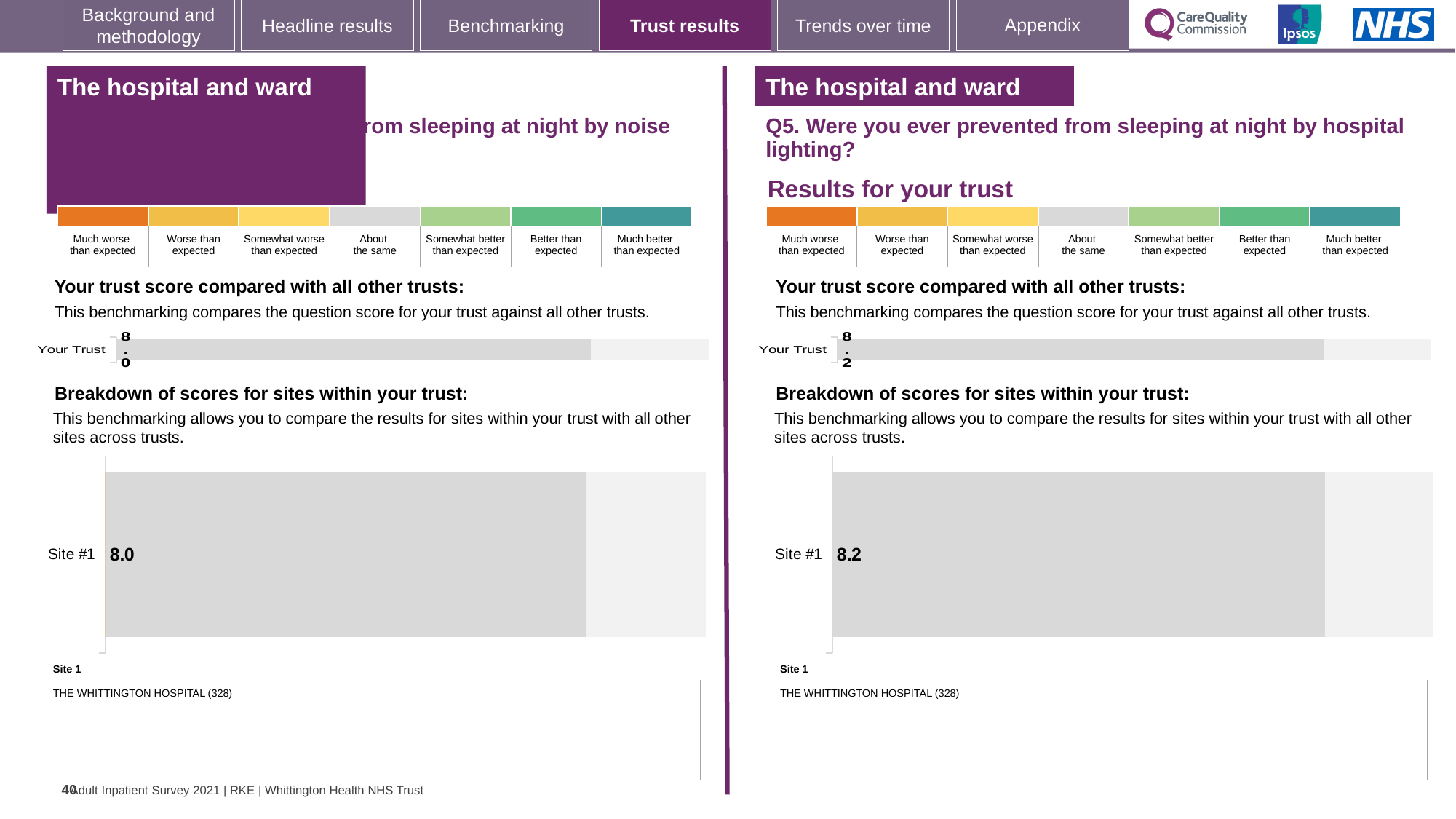
What kind of chart is used to show the Site #1 score on the left-hand side of the slide? Bar chart On the right-hand chart (Q5, hospital lighting), what is the score shown for Site #1? 8.2 Which is larger: the Your Trust score on the left-hand chart (noise) or the Your Trust score on the right-hand chart (Q5, hospital lighting)? Right-hand chart (Q5, hospital lighting) What is the difference between the Site #1 score on the right-hand chart (Q5, hospital lighting) and the Site #1 score on the left-hand chart (noise)? 0.2 On the left-hand chart (sleeping at night by noise), what is the score shown for Site #1? 8.0 On the right-hand chart (Q5, hospital lighting), what is the score for Your Trust? 8.2 On the left-hand chart (sleeping at night by noise), what is the score for Your Trust? 8.0 How many sites are shown in the 'Breakdown of scores for sites within your trust' chart on the right-hand side? 1 How many categories does the colour scale above the right-hand chart (Q5, hospital lighting) show, from 'Much worse than expected' to 'Much better than expected'? 7 Which hospital is listed as Site 1 on the right-hand side of the slide? THE WHITTINGTON HOSPITAL (328)